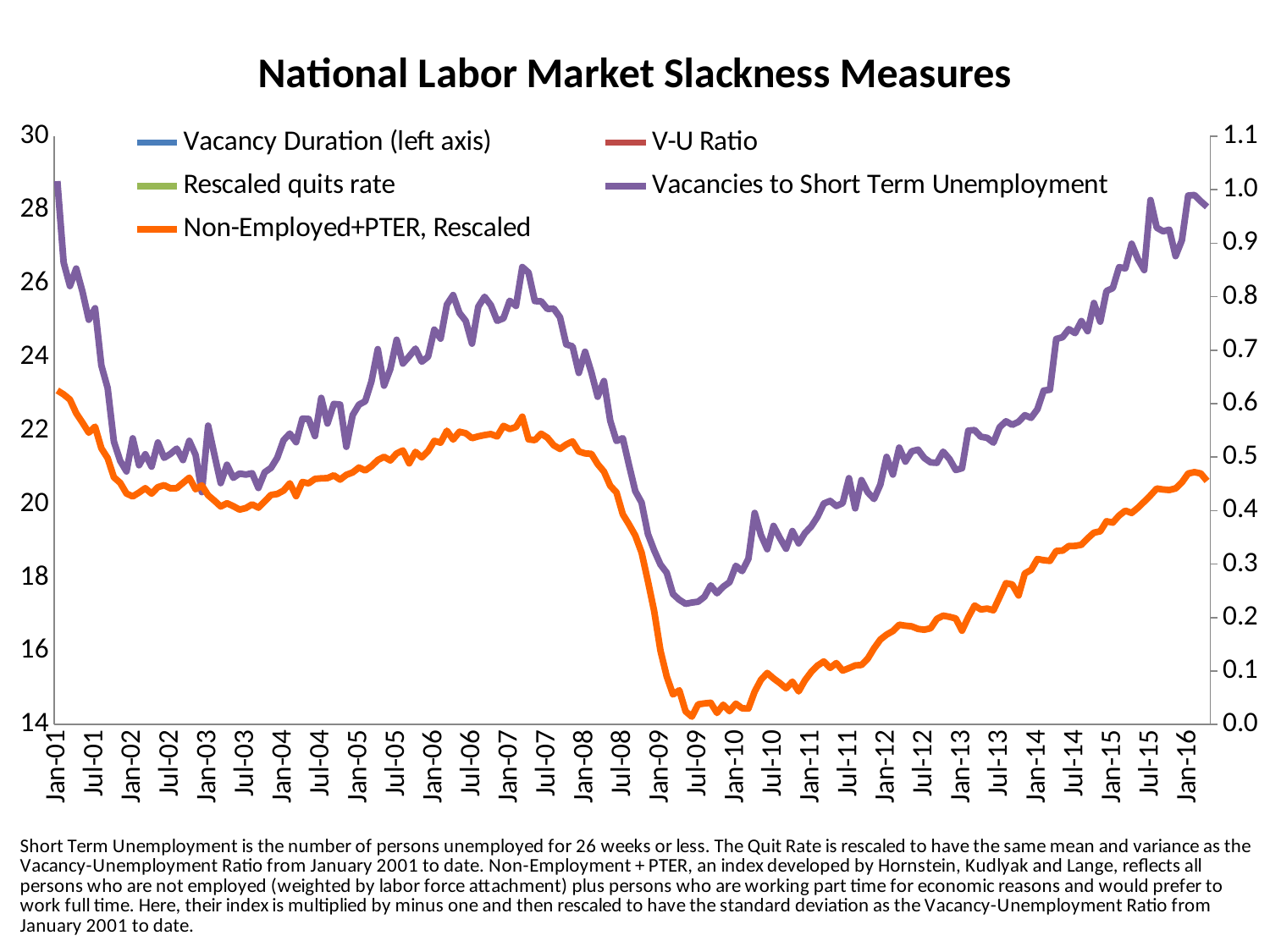
Is the value of the Vacancies to Short Term Unemployment line at Jul-09, read on the right axis, greater or less than 0.3? less At Jan-16, which line is plotted higher on the chart: Vacancies to Short Term Unemployment or Non-Employed+PTER, Rescaled? Vacancies to Short Term Unemployment Around which x-axis label does the Non-Employed+PTER, Rescaled line reach its lowest point? Jul-09 Does the Non-Employed+PTER, Rescaled line rise or fall between Jan-08 and Jul-09? fall Does the Vacancies to Short Term Unemployment line rise or fall between Jan-09 and Jan-16? rise How many series does the legend list? 5 Does the Vacancies to Short Term Unemployment line rise or fall between Jan-01 and Jan-02? fall What is the title of the chart? National Labor Market Slackness Measures What kind of chart is shown on the slide? line chart What colour is the Non-Employed+PTER, Rescaled line? orange Is the value of the Vacancies to Short Term Unemployment line at Jan-16, read on the right axis, greater or less than 0.9? greater What is the highest value shown on the left axis? 30